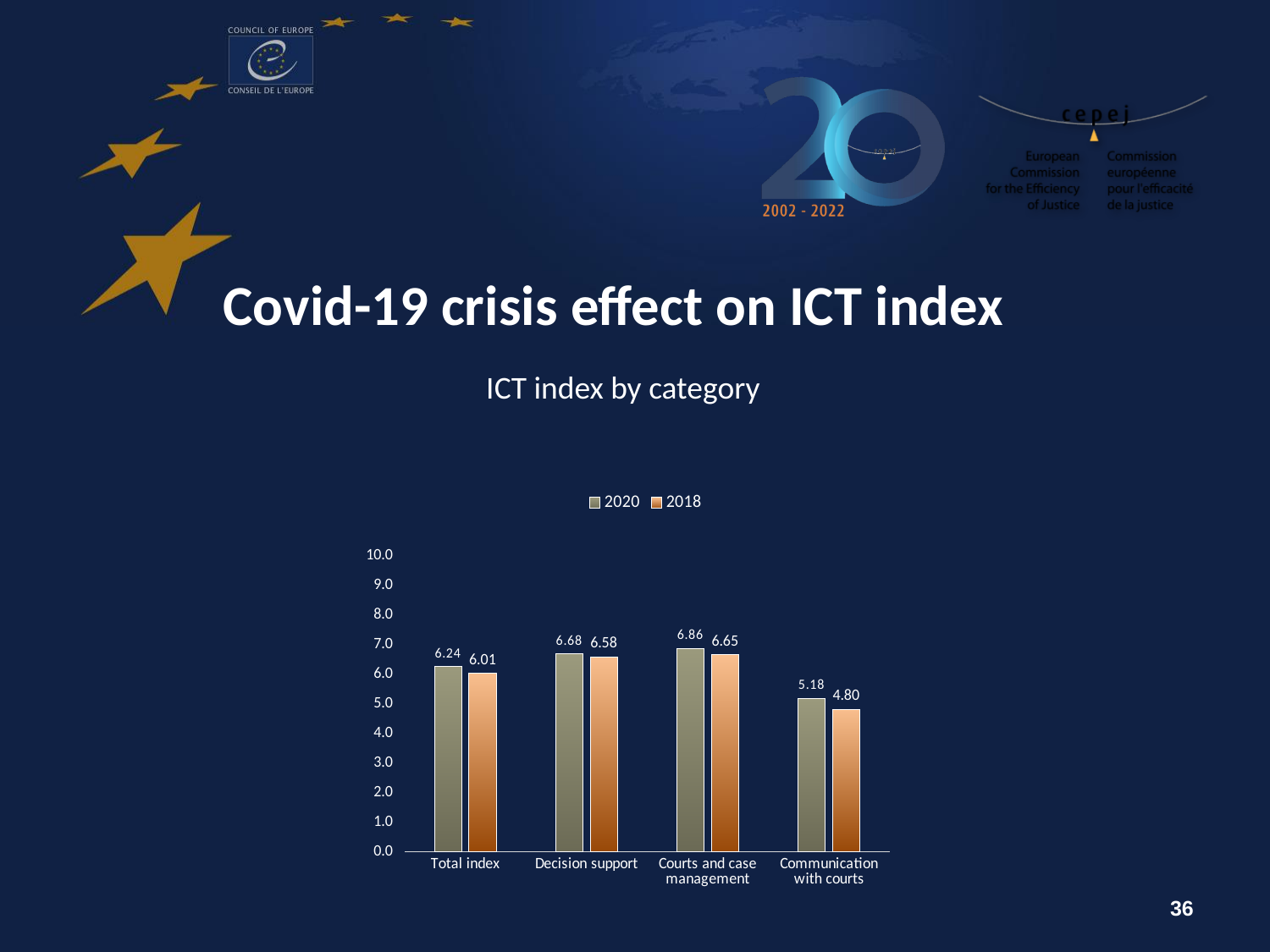
What kind of chart is shown on the slide? Bar chart Which is larger for Total index, the 2020 value or the 2018 value? 2020 Which category has the highest 2020 value? Courts and case management What is the 2020 value for Total index? 6.24 What is the 2018 value for Decision support? 6.58 How many categories are shown on the x axis? 4 Which category has the lowest 2018 value? Communication with courts What is the 2020 value for Courts and case management? 6.86 What is the difference between the 2020 and 2018 values for Communication with courts? 0.38 What is the title of the chart? ICT index by category How many series does the legend list? 2 What is the 2018 value for Communication with courts? 4.80